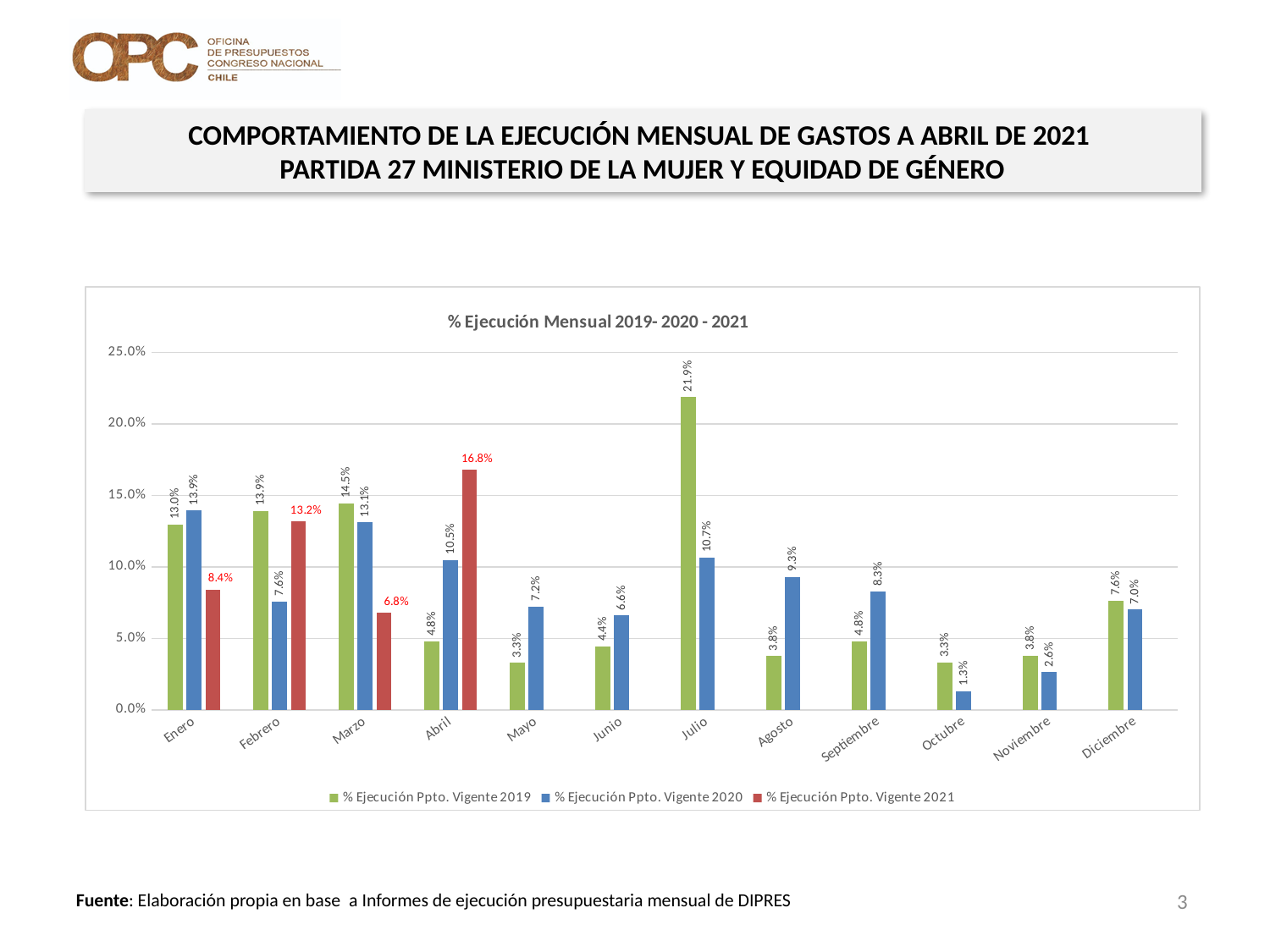
What is the title of the chart? % Ejecución Mensual 2019- 2020 - 2021 What is the value for % Ejecución Ppto. Vigente 2020 in Agosto? 9.3% Is the value for % Ejecución Ppto. Vigente 2019 in Julio greater or less than 20.0%? greater How many months are shown on the x axis? 12 What is the value for % Ejecución Ppto. Vigente 2019 in Diciembre? 7.6% In which month is the % Ejecución Ppto. Vigente 2020 series lowest? Octubre What is the difference between the 2021 and 2020 values in Abril? 6.3% In which month is the % Ejecución Ppto. Vigente 2019 series highest? Julio Which is larger in Febrero: the 2019 value or the 2020 value? 2019 (13.9%) What type of chart is shown on the slide? Bar chart What is the value for % Ejecución Ppto. Vigente 2021 in Abril? 16.8% How many series does the legend list? 3